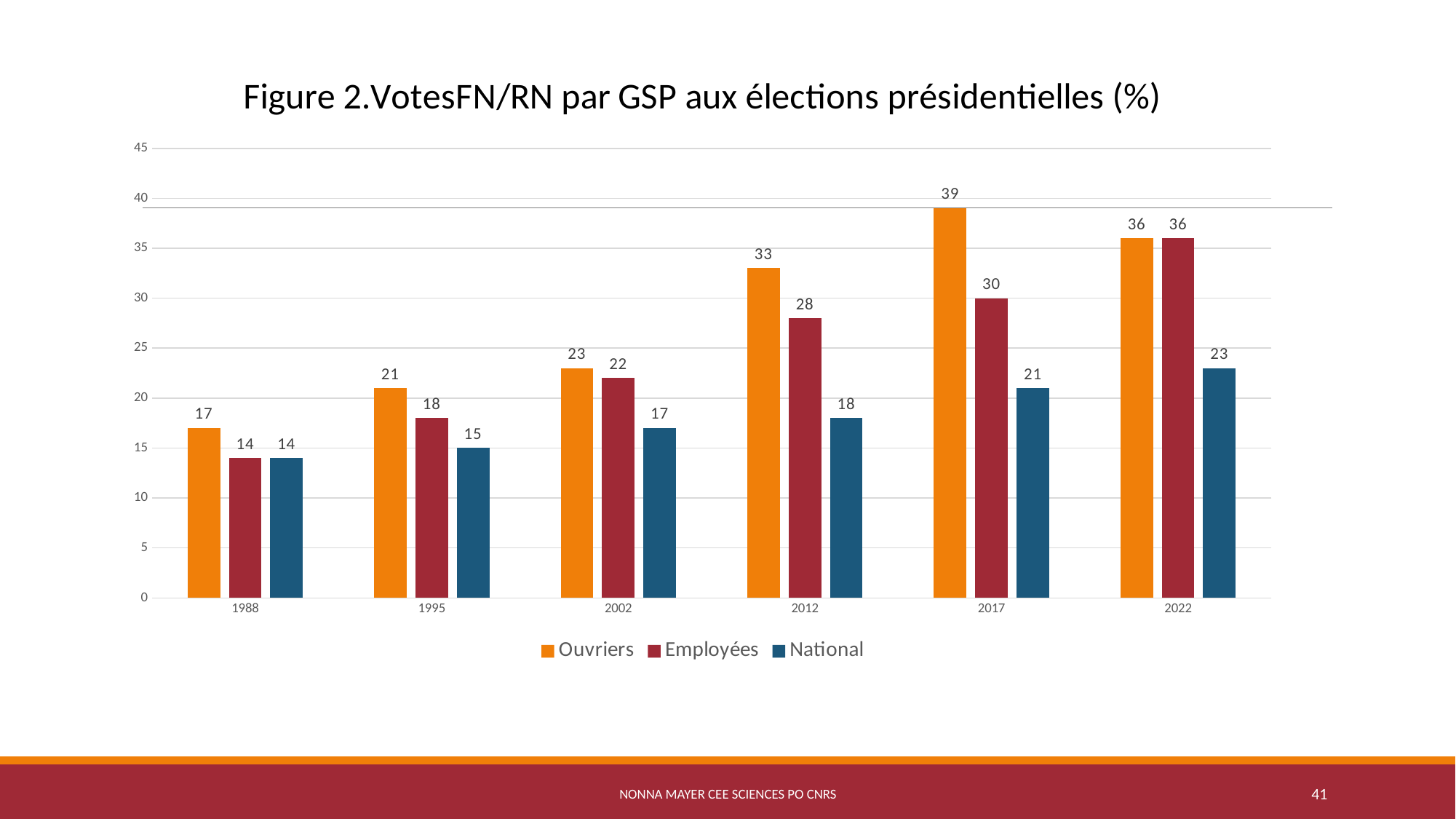
What is the value for Ouvriers in 2017? 39 What is the difference between the Ouvriers and National values in 2017? 18 What is the value for Employées in 2012? 28 In which year is the Ouvriers value highest? 2017 What is the value for National in 2022? 23 Which is larger in 1995, the Ouvriers value or the Employées value? Ouvriers In which year is the National value lowest? 1988 What kind of chart is shown on the slide? bar chart How many years are shown on the x axis? 6 What is the title of the chart? Figure 2.VotesFN/RN par GSP aux élections présidentielles (%) Does the Employées value rise or fall from 1988 to 2022? rise How many series does the legend list? 3